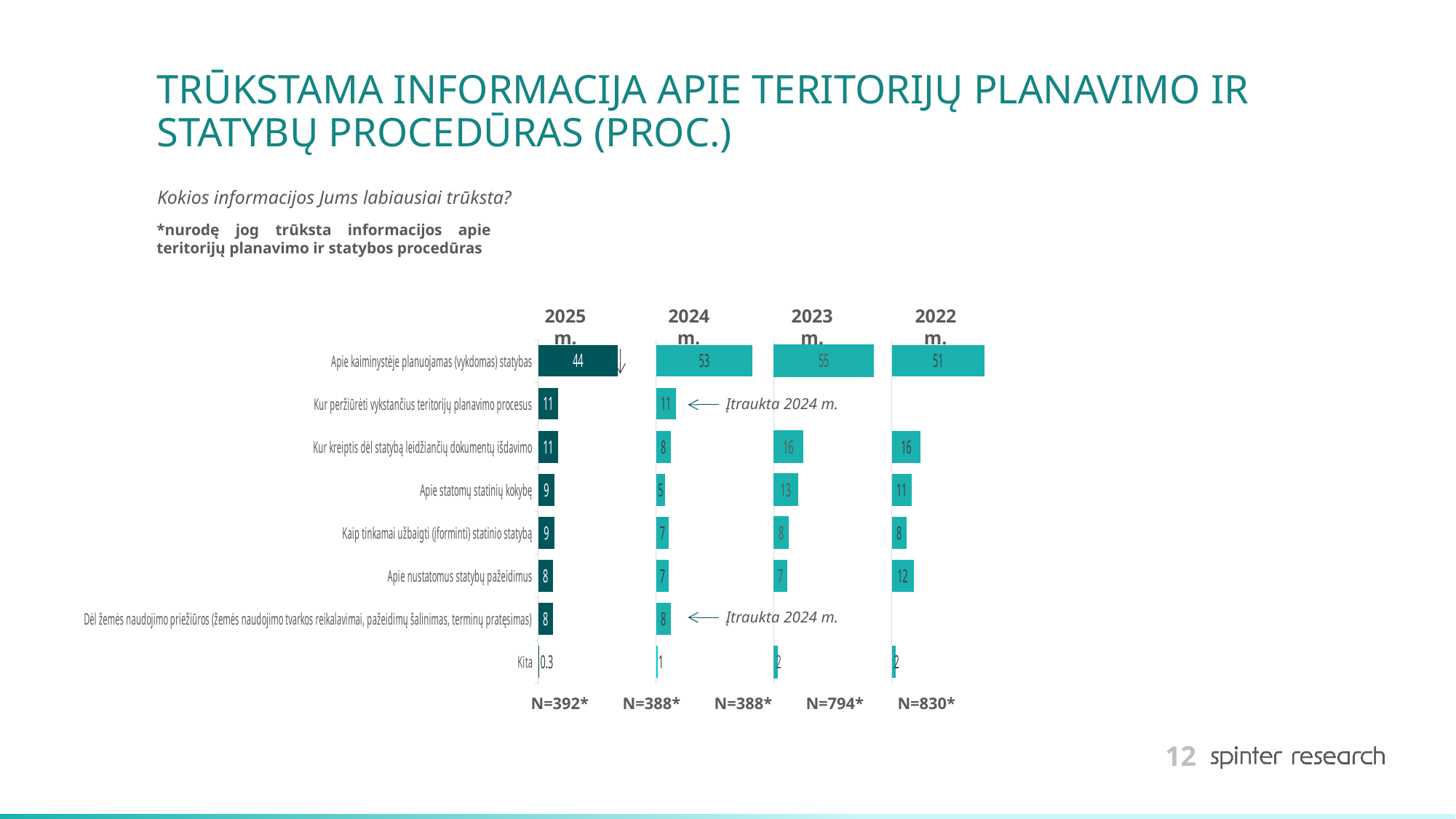
In the 2023 m. chart, what is the value for "Kur kreiptis dėl statybą leidžiančių dokumentų išdavimo"? 16 In the 2022 m. chart, which category has the lowest value? Kita What is the difference between the 2023 m. value and the 2025 m. value for "Apie kaiminystėje planuojamas (vykdomas) statybas"? 11 For "Apie statomų statinių kokybę", which year has the larger value: 2023 m. or 2022 m.? 2023 m. In the 2023 m. chart, which category has the highest value? Apie kaiminystėje planuojamas (vykdomas) statybas In the 2024 m. chart, what is the value for "Apie statomų statinių kokybę"? 5 In the 2025 m. chart, what is the value for "Kita"? 0.3 According to the annotation, in which year were the categories "Kur peržiūrėti vykstančius teritorijų planavimo procesus" and "Dėl žemės naudojimo priežiūros" included? 2024 m. What type of chart is used on this slide? Bar chart In the 2022 m. chart, what is the value for "Apie nustatomus statybų pažeidimus"? 12 How many categories are listed in the 2025 m. chart? 8 In the 2025 m. chart, what is the value for "Apie kaiminystėje planuojamas (vykdomas) statybas"? 44